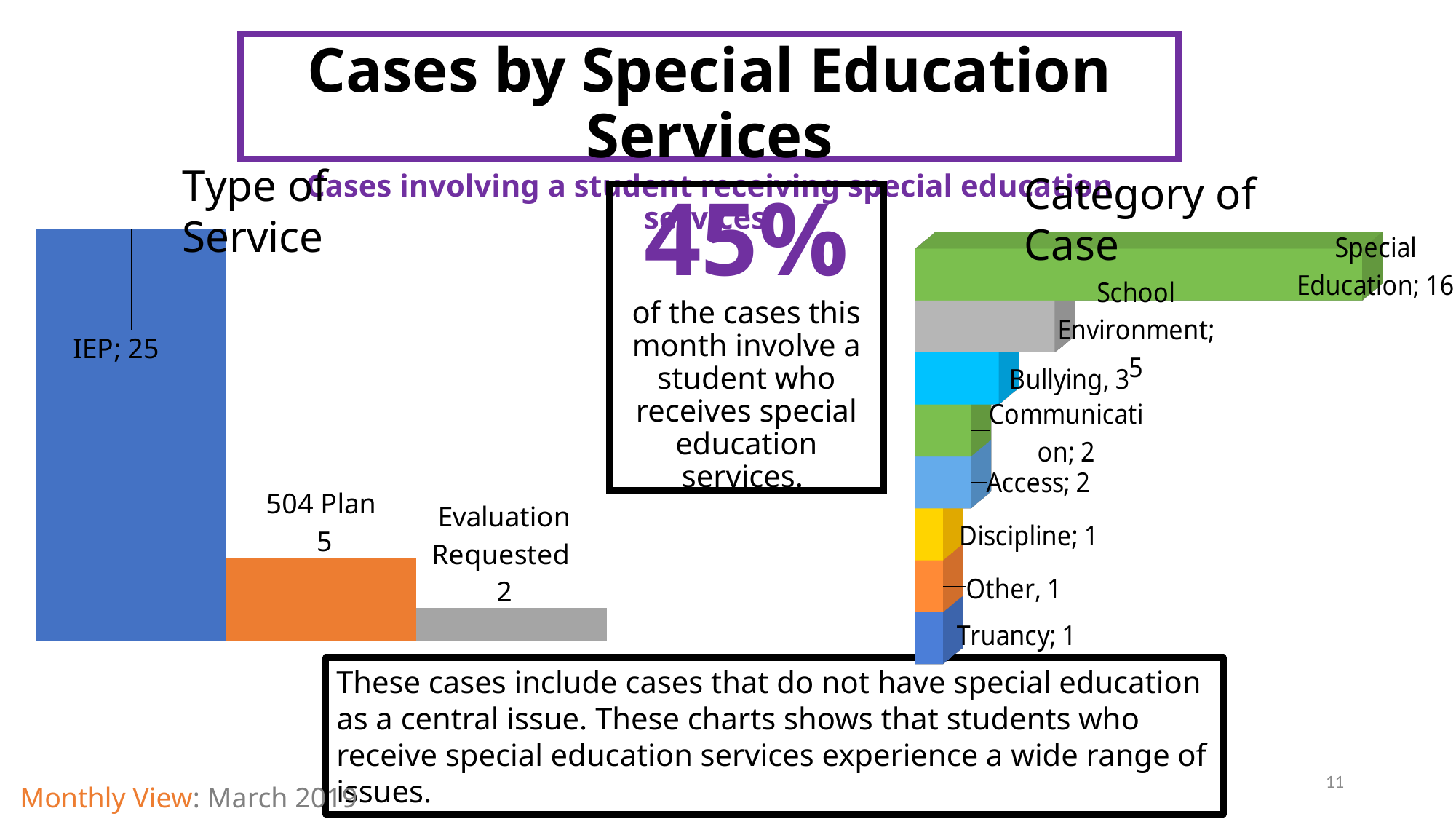
In the Category of Case chart, which category has the highest value? Special Education In the Type of Service chart, what is the value for IEP? 25 In the Type of Service chart, what is the difference between IEP and 504 Plan? 20 In the Category of Case chart, which is larger, Bullying or Access? Bullying In the Type of Service chart, what is the value for 504 Plan? 5 In the Type of Service chart, which category has the highest value? IEP In the Category of Case chart, what is the value for Bullying? 3 In the Type of Service chart, how many categories are shown? 3 In the Type of Service chart, what is the value for Evaluation Requested? 2 In the Category of Case chart, how many categories are shown? 8 In the Category of Case chart, what is the value for Special Education? 16 In the Category of Case chart, what is the value for School Environment? 5